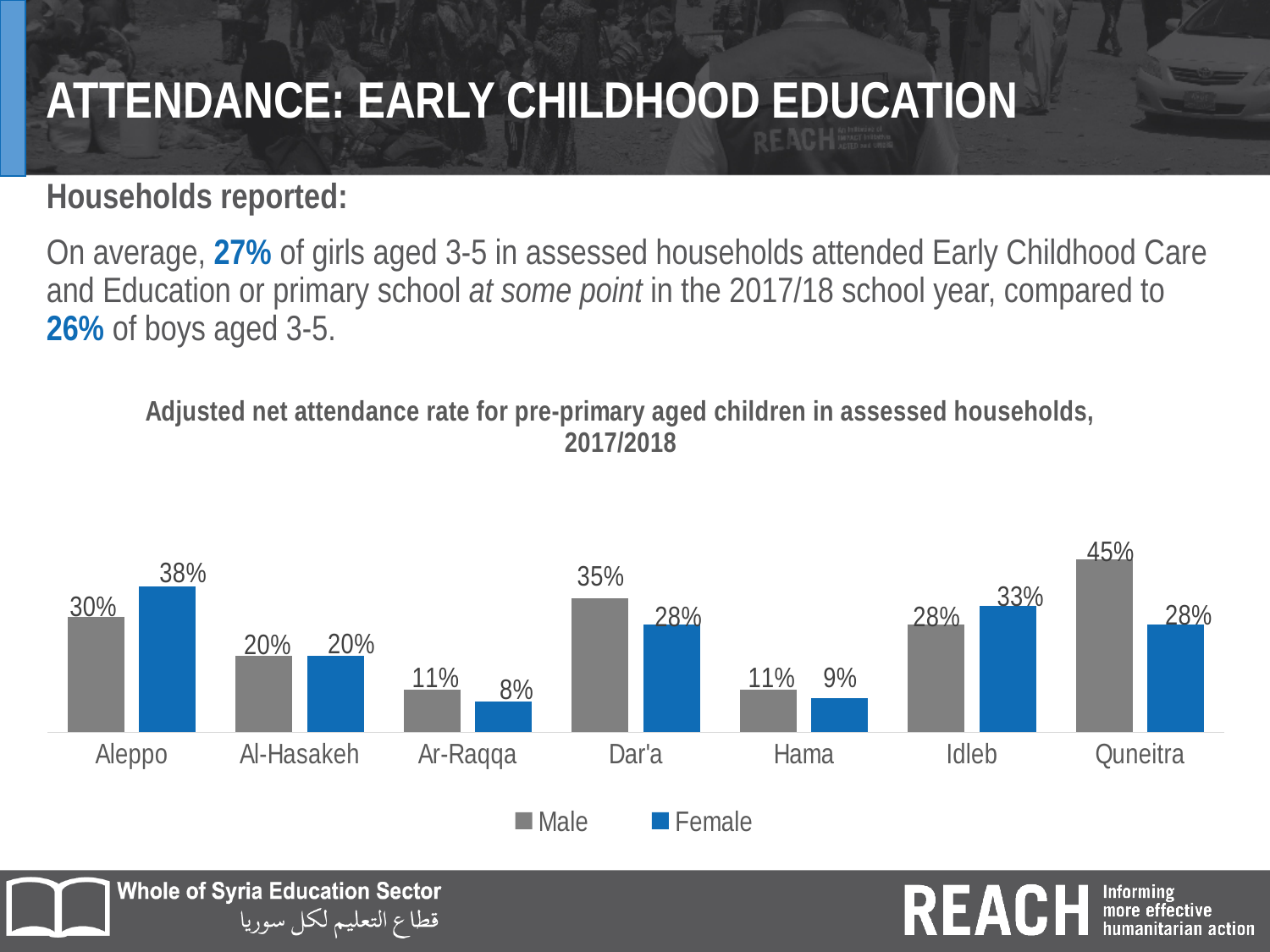
How many series does the legend list? 2 What is the Male value for Aleppo? 30% Which is larger for Dar'a, the Male value or the Female value? Male What kind of chart is shown? Bar chart Which governorate has the highest Male value? Quneitra What is the Female value for Ar-Raqqa? 8% Which colour represents the Female series? Blue What is the Female value for Quneitra? 28% What is the difference between the Female and Male values for Aleppo? 8% Which governorate has the lowest Female value? Ar-Raqqa What is the difference between the Male values for Quneitra and Hama? 34% How many governorates are shown on the x axis? 7